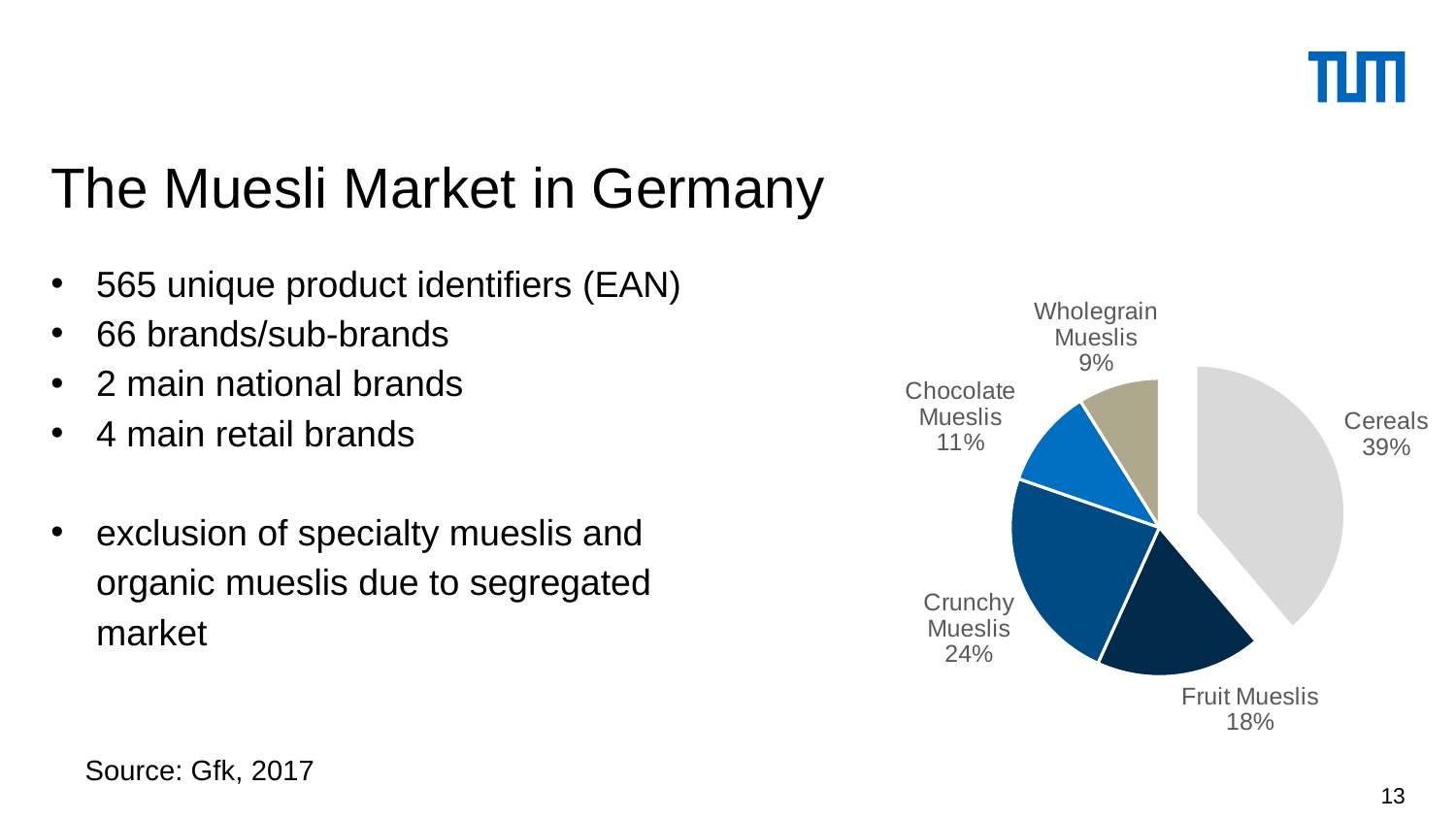
Which is larger, the share for Fruit Mueslis or the share for Chocolate Mueslis? Fruit Mueslis What share of the pie chart does Fruit Mueslis have? 18% What share of the pie chart does Chocolate Mueslis have? 11% What kind of chart is shown on the slide? Pie chart Which category has the largest slice of the pie chart? Cereals What share of the pie chart does Cereals have? 39% Which category has the smallest slice of the pie chart? Wholegrain Mueslis What is the difference in percentage points between Cereals and Crunchy Mueslis? 15 What share of the pie chart does Wholegrain Mueslis have? 9% What share of the pie chart does Crunchy Mueslis have? 24% Which slice of the pie chart is pulled out from the rest? Cereals How many categories are shown in the pie chart? 5